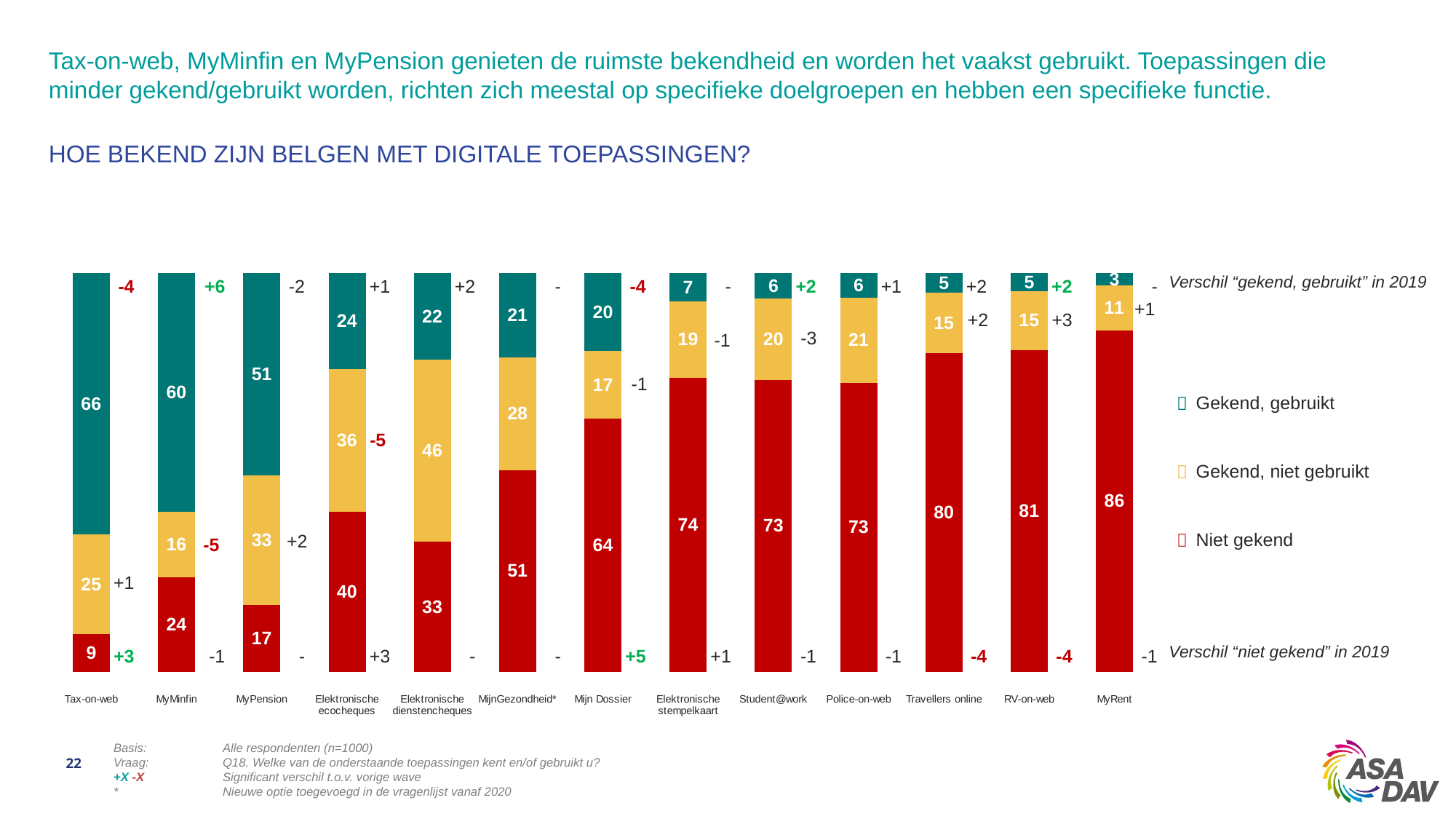
Which colour represents "Niet gekend" in the chart? Red What kind of chart is shown on the slide? Stacked bar chart What is the value of "Niet gekend" for MyRent? 86 How many series does the legend list? 3 What is the value of "Gekend, niet gebruikt" for Elektronische dienstencheques? 46 Which application has the lowest "Gekend, gebruikt" value? MyRent Which application has the highest "Niet gekend" value? MyRent What is the value of "Gekend, gebruikt" for Tax-on-web? 66 Which has a larger "Niet gekend" value: Elektronische ecocheques or Elektronische dienstencheques? Elektronische ecocheques What is the difference between the "Gekend, gebruikt" values for Tax-on-web and MyMinfin? 6 How many applications are shown on the x axis of the chart? 13 What is the total of the stacked bar for Tax-on-web? 100